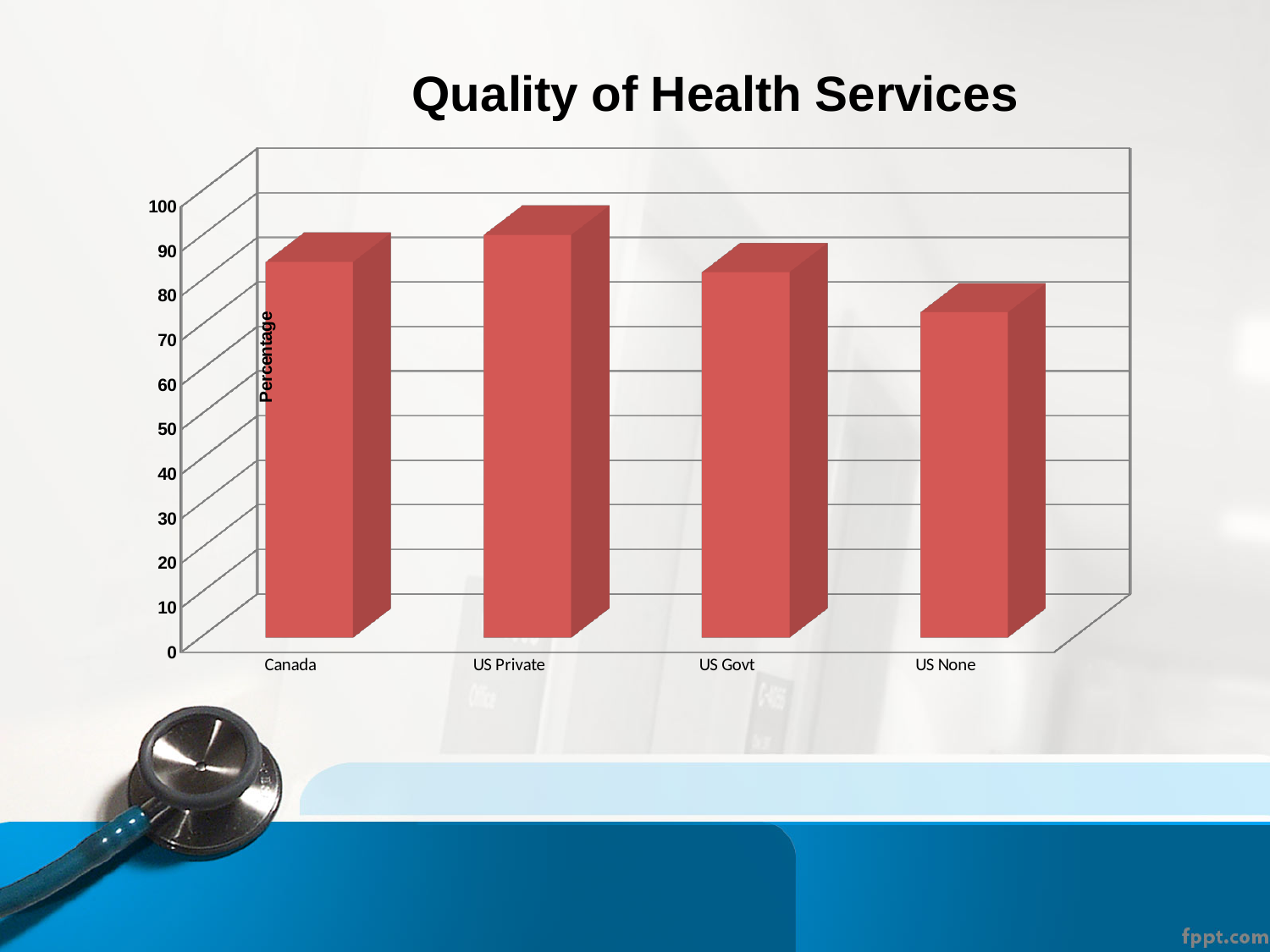
Which category has the lowest value in the chart? US None Which is larger, the value for US Private or the value for US None? US Private Is the value for US None greater or less than 80? less Which category has the highest value in the chart? US Private Is the value for Canada greater or less than 80? greater How many categories are shown on the x axis of the chart? 4 Which is larger, the value for Canada or the value for US None? Canada What kind of chart is shown on the slide? bar chart What is the label of the vertical axis? Percentage What is the title of the chart? Quality of Health Services Is the value for US Private greater or less than 80? greater